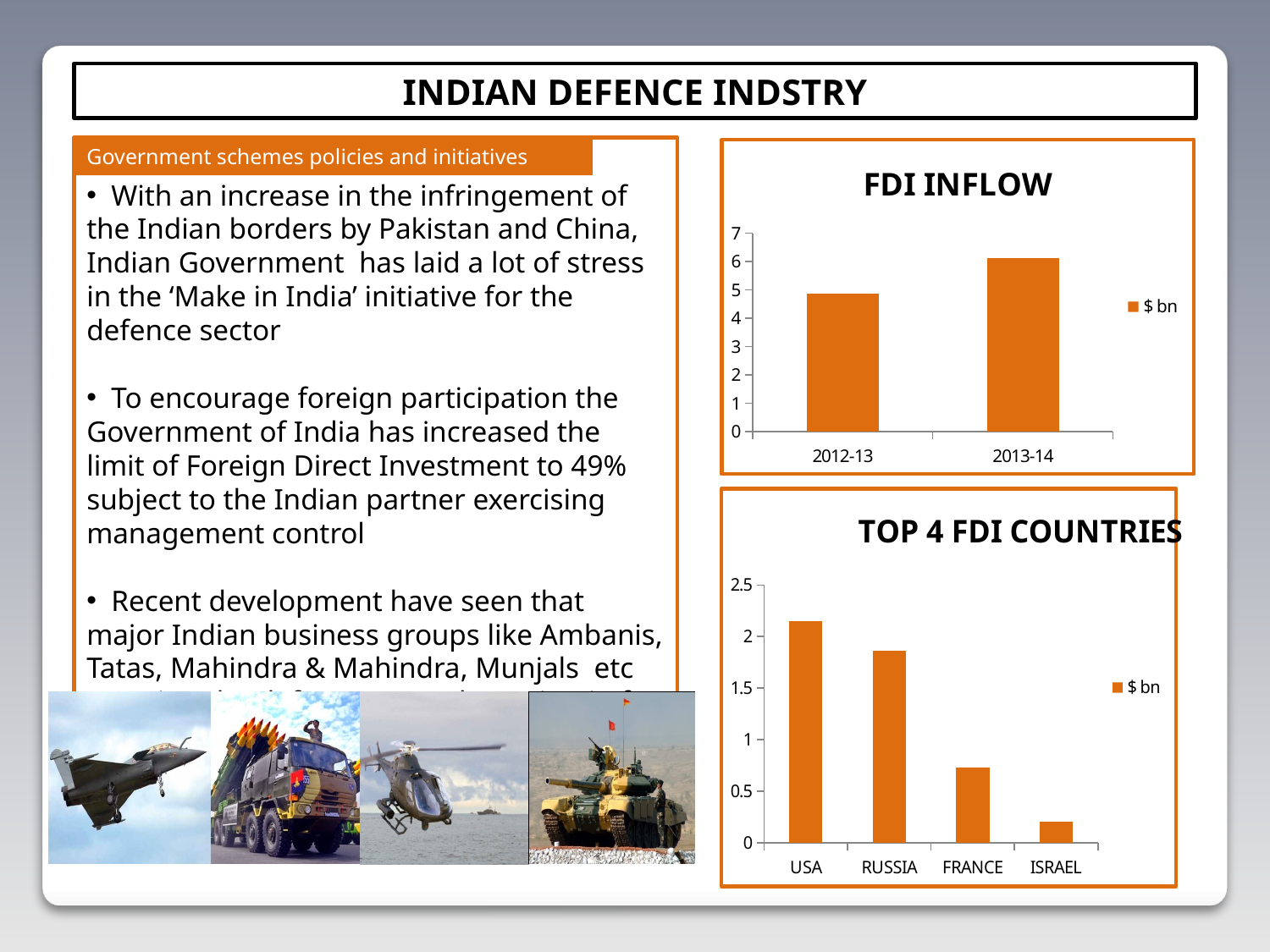
In the TOP 4 FDI COUNTRIES chart, which country has the lowest value? ISRAEL In the TOP 4 FDI COUNTRIES chart, which is larger, the value for RUSSIA or the value for FRANCE? RUSSIA In the TOP 4 FDI COUNTRIES chart, do the values rise or fall from USA to ISRAEL along the x axis? fall How many series does the legend of the TOP 4 FDI COUNTRIES chart list? 1 In the FDI INFLOW chart, which year has the higher value? 2013-14 What kind of chart is the FDI INFLOW chart? bar chart In the FDI INFLOW chart, do the values rise or fall from 2012-13 to 2013-14? rise How many categories are shown in the FDI INFLOW chart? 2 In the TOP 4 FDI COUNTRIES chart, which country has the highest value? USA In the TOP 4 FDI COUNTRIES chart, is the value for FRANCE greater or less than 1? less